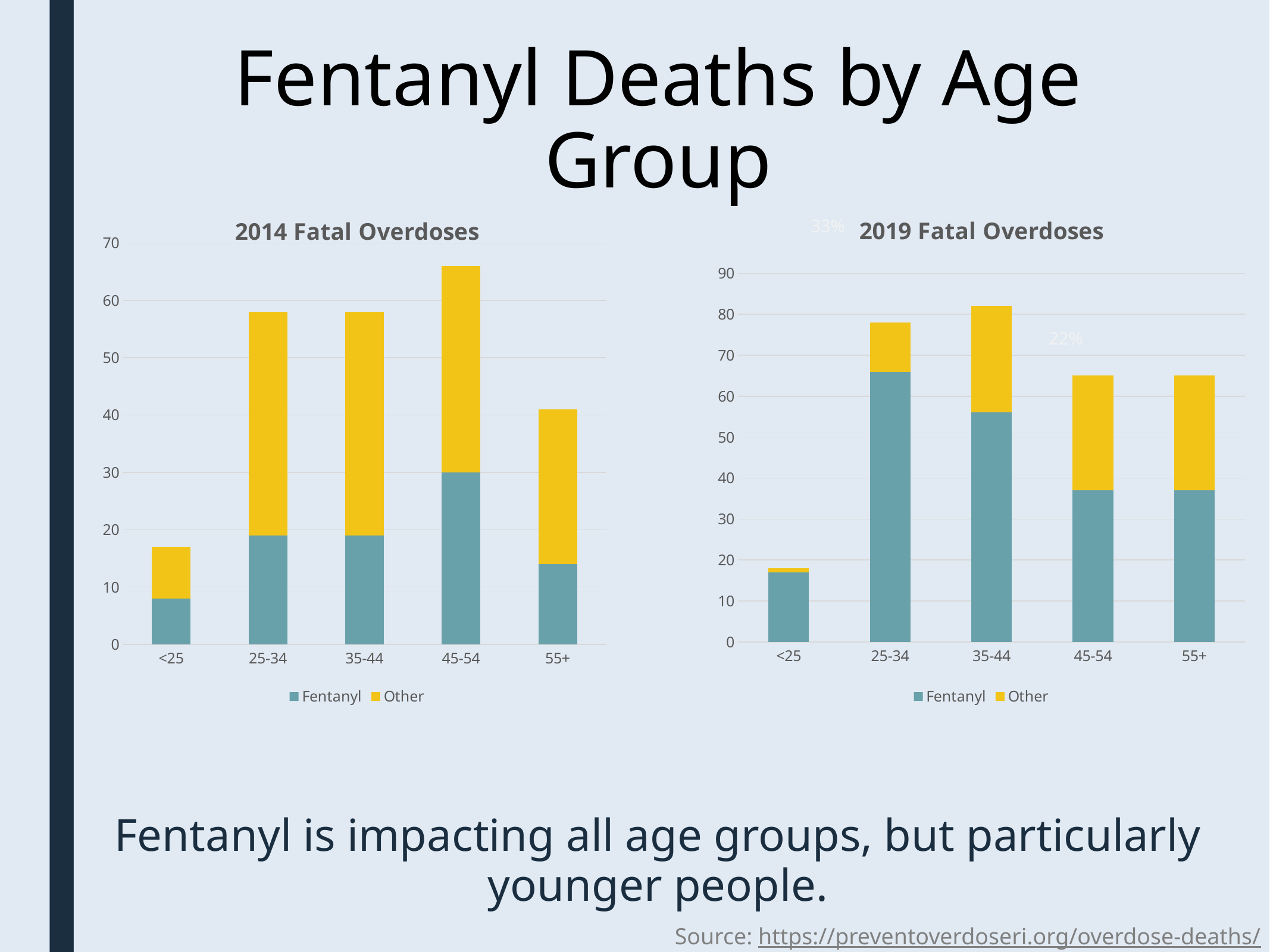
In the 2019 Fatal Overdoses chart, which age group has the lowest total bar? <25 How many series does the legend of the 2014 Fatal Overdoses chart list? 2 In the 2019 Fatal Overdoses chart, which age group has the highest Fentanyl value? 25-34 In the 2019 Fatal Overdoses chart, is the total for <25 greater or less than 20? less What kind of chart is the 2014 Fatal Overdoses chart? stacked bar chart Which colour represents Fentanyl in the legend of the 2019 Fatal Overdoses chart? teal In the 2014 Fatal Overdoses chart, which age group has the highest total bar? 45-54 In the 2019 Fatal Overdoses chart, which is larger for the 25-34 group, the Fentanyl value or the Other value? Fentanyl How many age groups are shown on the 2019 Fatal Overdoses chart? 5 In the 2014 Fatal Overdoses chart, which age group has the lowest total bar? <25 In the 2014 Fatal Overdoses chart, is the total for 45-54 greater or less than 60? greater In the 2019 Fatal Overdoses chart, is the Fentanyl value for 25-34 greater or less than 60? greater